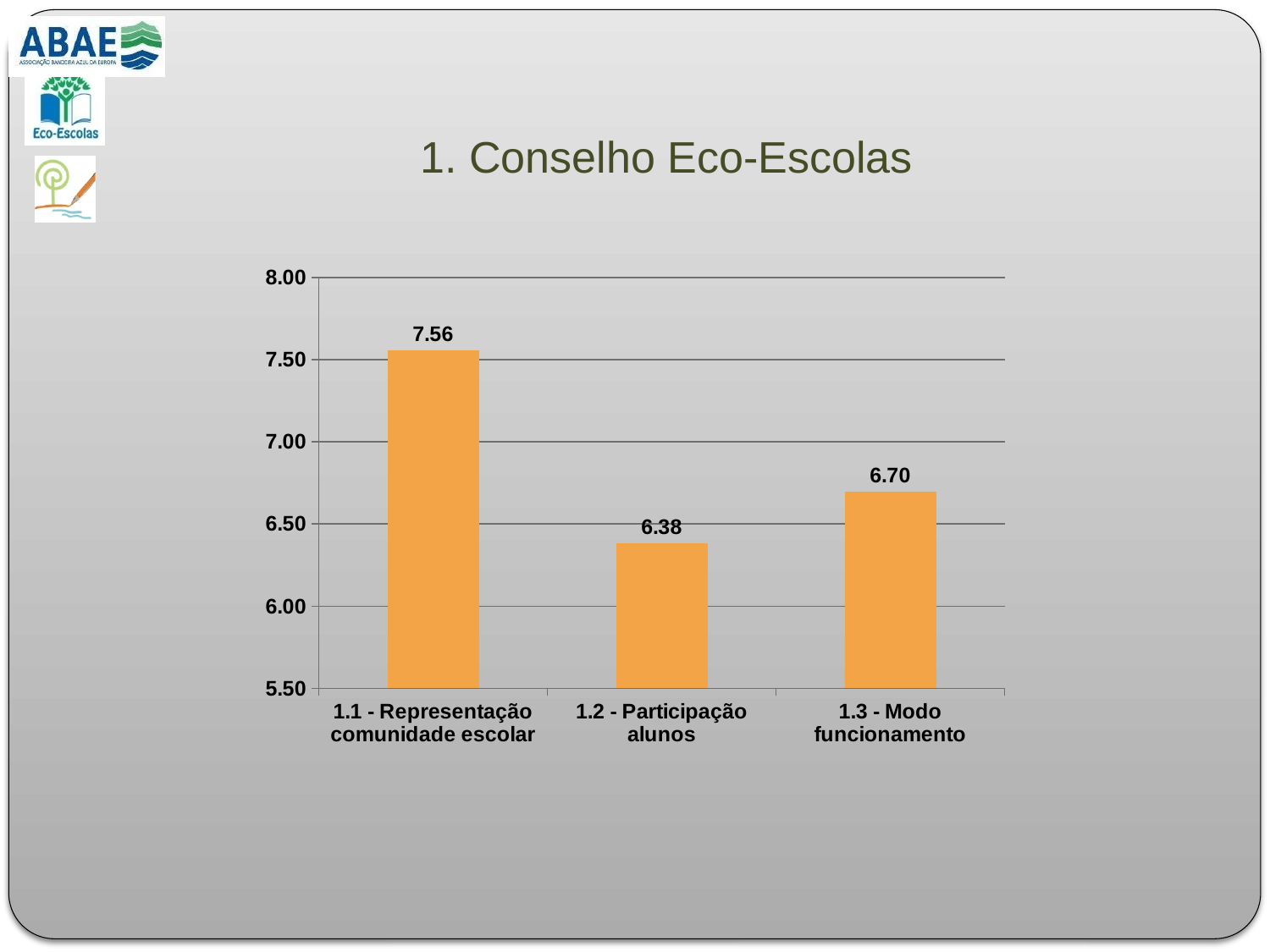
What is the title of the slide containing the chart? 1. Conselho Eco-Escolas What is the difference between the values for 1.1 - Representação comunidade escolar and 1.2 - Participação alunos? 1.18 What is the value for 1.2 - Participação alunos? 6.38 How many categories are shown in the chart? 3 Which category has the highest value? 1.1 - Representação comunidade escolar Which category has the lowest value? 1.2 - Participação alunos What is the value for 1.3 - Modo funcionamento? 6.70 Is the value for 1.1 - Representação comunidade escolar greater or less than 7.00? greater What is the difference between the values for 1.3 - Modo funcionamento and 1.2 - Participação alunos? 0.32 Which is larger, the value for 1.3 - Modo funcionamento or the value for 1.2 - Participação alunos? 1.3 - Modo funcionamento What kind of chart is shown on the slide? bar chart What is the value for 1.1 - Representação comunidade escolar? 7.56